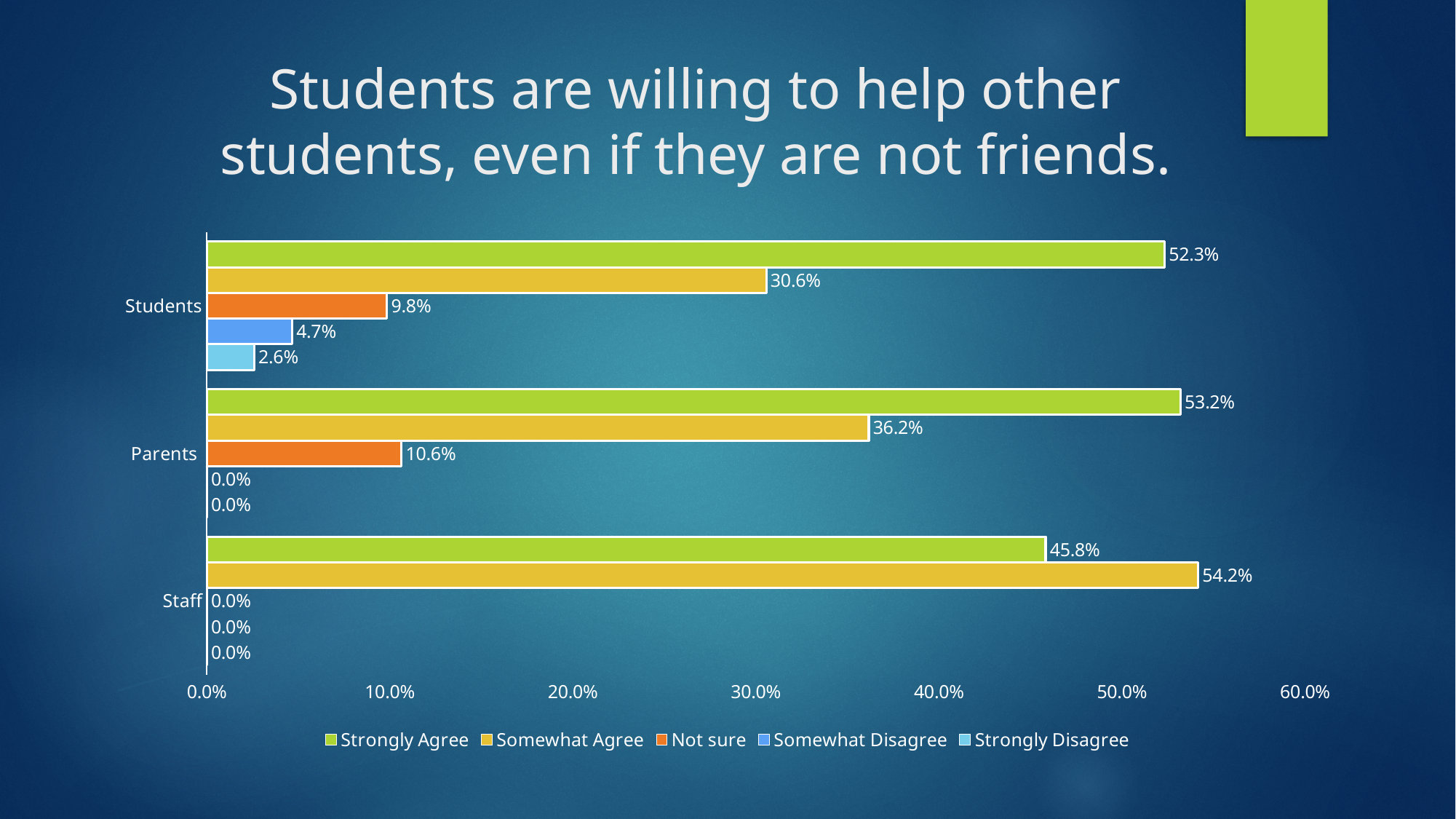
Which group has the lowest Strongly Agree percentage? Staff What is the difference between the Somewhat Agree percentages for Staff and Students? 23.6% Which is larger for Staff: Strongly Agree or Somewhat Agree? Somewhat Agree What percentage of Students responded Strongly Agree? 52.3% What percentage of Students responded Strongly Disagree? 2.6% Is the Not sure value for Parents greater or less than 20.0%? less What percentage of Parents responded Somewhat Agree? 36.2% What kind of chart is shown on the slide? Bar chart How many series does the legend list? 5 How many groups are shown on the y axis? 3 Which group has the highest Strongly Agree percentage? Parents What percentage of Staff responded Somewhat Agree? 54.2%